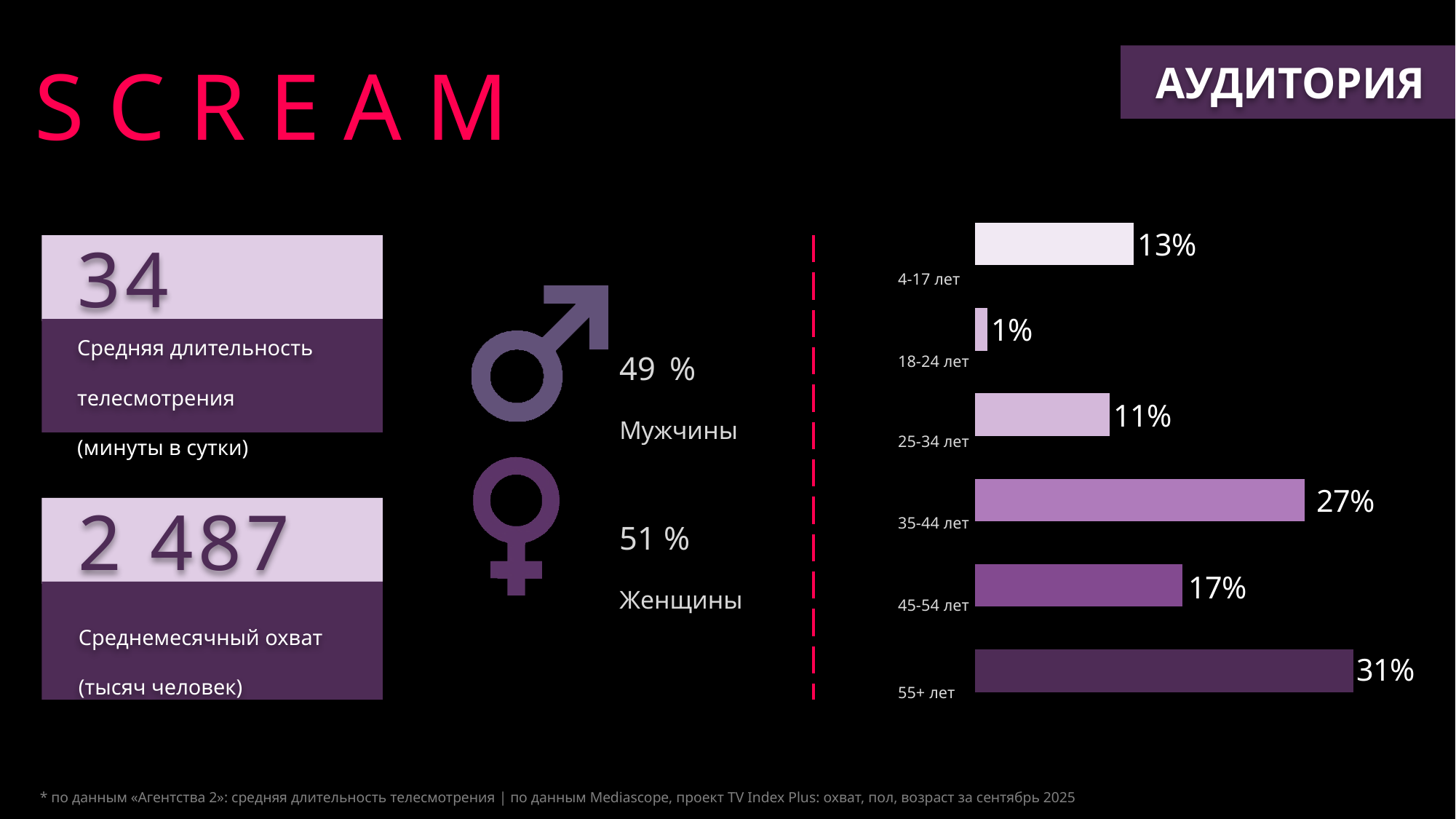
In the age-group bar chart, what is the value for 55+ лет? 31% In the age-group bar chart, what is the value for 35-44 лет? 27% In the age-group bar chart, what is the difference between the values for 45-54 лет and 25-34 лет? 6% In the age-group bar chart, what is the value for 18-24 лет? 1% What is the title shown in the box at the top right of the slide? АУДИТОРИЯ In the age-group bar chart, which age group has the highest value? 55+ лет How many age groups are shown in the bar chart? 6 In the age-group bar chart, which is larger: the value for 4-17 лет or the value for 25-34 лет? 4-17 лет What kind of chart is used to show the age groups on the slide? Bar chart In the age-group bar chart, which age group has the lowest value? 18-24 лет In the age-group bar chart, what is the difference between the values for 55+ лет and 35-44 лет? 4% In the age-group bar chart, what is the value for 4-17 лет? 13%